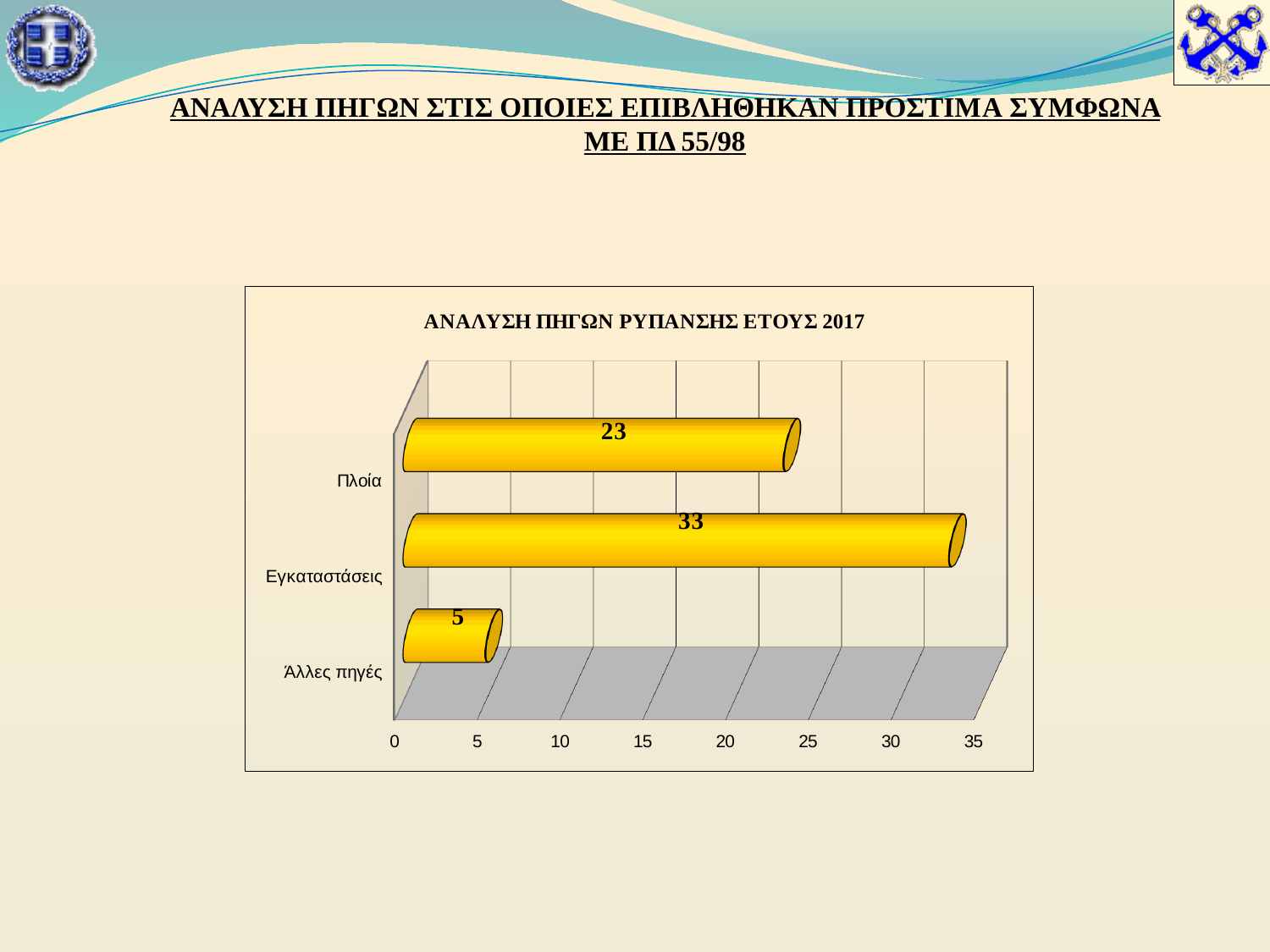
Which category has the highest value? Εγκαταστάσεις What is the value for Άλλες πηγές? 5 Is the value for Πλοία greater or less than 20? greater What kind of chart is shown on the slide? bar chart What is the value for Πλοία? 23 What is the difference between the values for Εγκαταστάσεις and Πλοία? 10 Which category has the lowest value? Άλλες πηγές What is the title of the chart? ΑΝΑΛΥΣΗ ΠΗΓΩΝ ΡΥΠΑΝΣΗΣ ΕΤΟΥΣ 2017 Which is larger, the value for Πλοία or the value for Εγκαταστάσεις? Εγκαταστάσεις How many categories are shown in the chart? 3 What is the difference between the values for Πλοία and Άλλες πηγές? 18 What is the value for Εγκαταστάσεις? 33